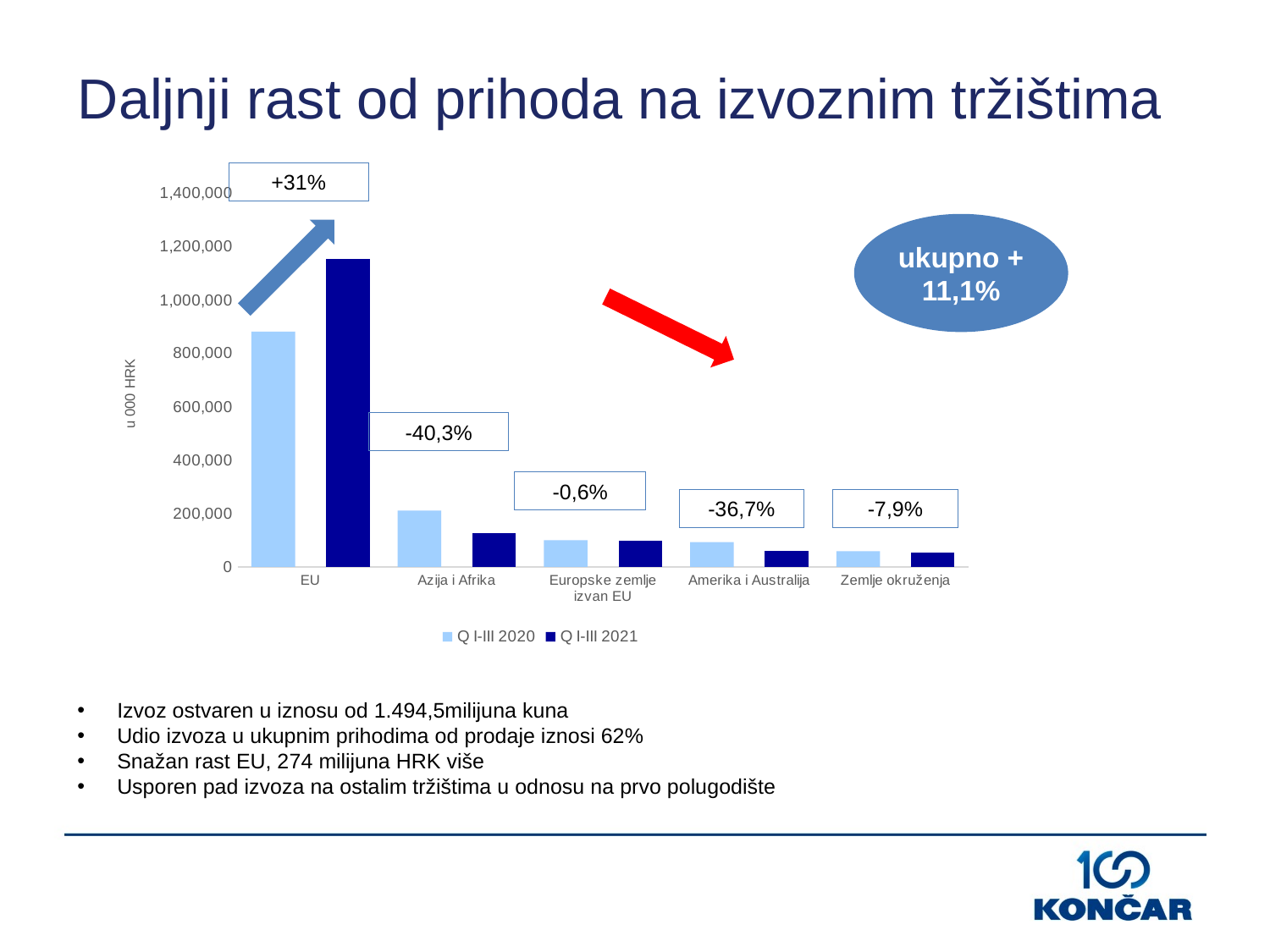
How many categories are shown on the x axis of the chart? 5 What unit is given on the y axis of the chart? u 000 HRK Which is larger for EU: the Q I-III 2020 value or the Q I-III 2021 value? Q I-III 2021 Which is larger for Azija i Afrika: the Q I-III 2020 value or the Q I-III 2021 value? Q I-III 2020 Which category has the highest Q I-III 2021 value? EU Which category has the lowest Q I-III 2020 value? Zemlje okruženja Is the Q I-III 2020 value for EU greater or less than 1,000,000? less Is the Q I-III 2021 value for EU greater or less than 1,000,000? greater What kind of chart is shown on the slide? bar chart How many series does the chart legend list? 2 What percentage change is annotated above the Azija i Afrika bars? -40,3%